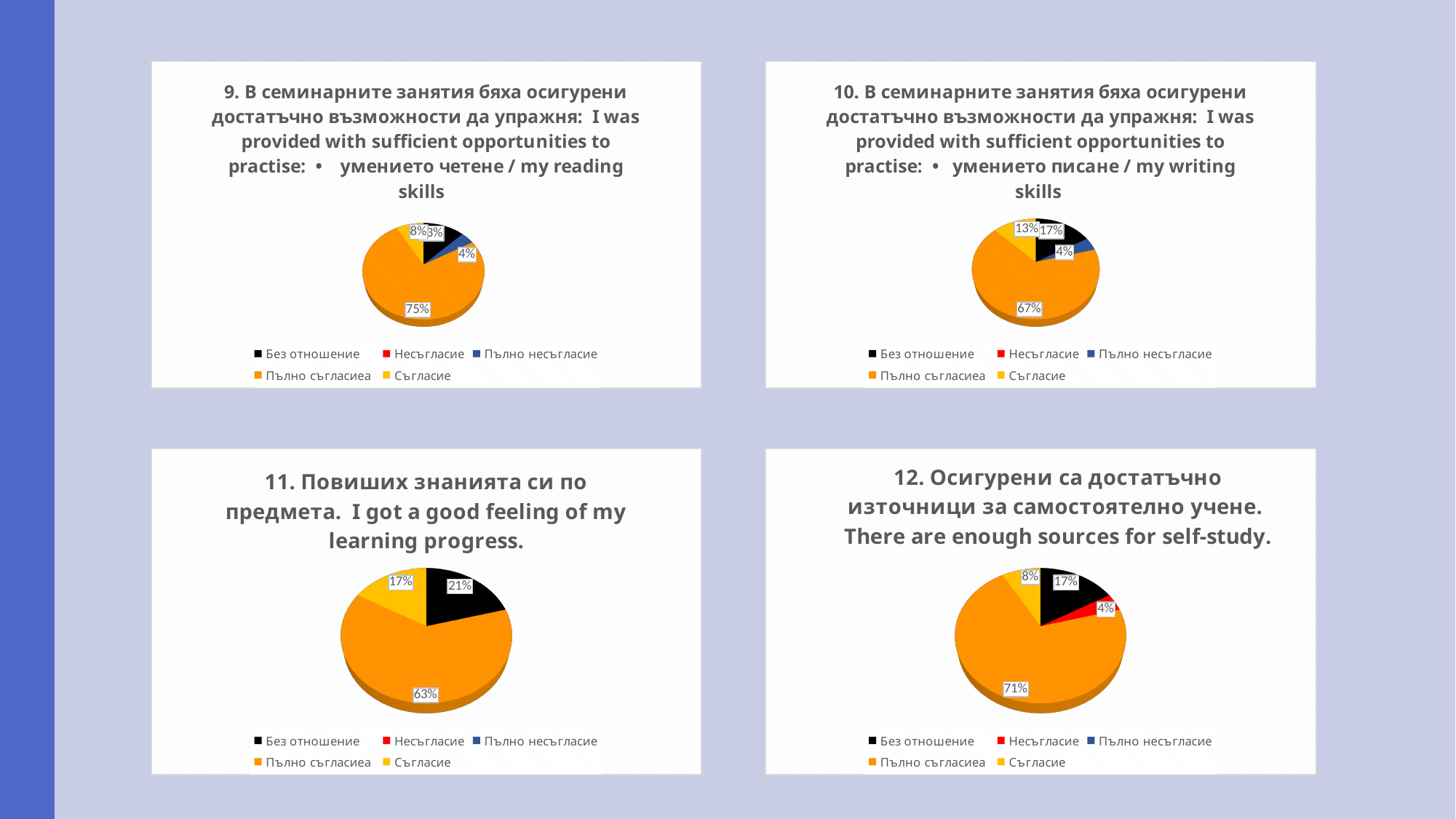
How many pie charts are shown on the slide? 4 In the chart for question 12 (bottom-right), which category has the largest share? Пълно съгласие In the chart for question 11 (bottom-left, learning progress), what percentage is shown for Съгласие (the yellow slice)? 17% In the chart for question 10 (top-right), which is larger: the Без отношение share or the Съгласие share? Без отношение How many entries does the legend list for the chart for question 12 (bottom-right)? 5 In the chart for question 9 (top-left, my reading skills), what percentage is shown for Пълно съгласие (the orange slice)? 75% What type of chart is used for question 11 (bottom-left)? Pie chart In the chart for question 9 (top-left), what percentage is shown for Пълно несъгласие (the blue slice)? 4% In the chart for question 10 (top-right, my writing skills), what percentage is shown for Без отношение (the black slice)? 17% In the chart for question 11 (bottom-left), what is the difference between the Пълно съгласие share and the Без отношение share? 42% In the chart for question 12 (bottom-right, sources for self-study), what percentage is shown for Несъгласие (the red slice)? 4%